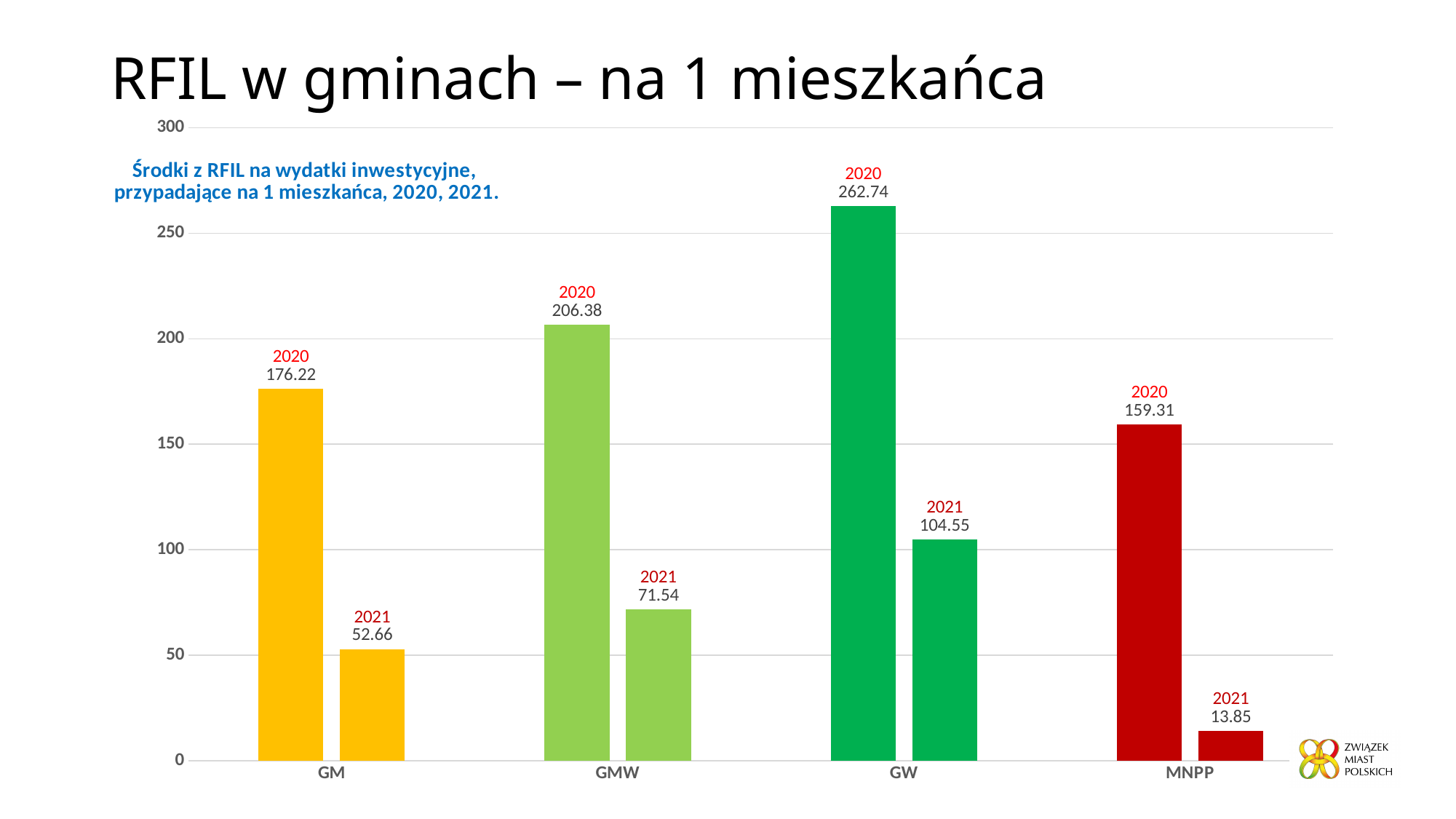
What is the 2020 value for GW? 262.74 What is the difference between the 2020 and 2021 values for GM? 123.56 What is the title of the slide? RFIL w gminach – na 1 mieszkańca Which category has the highest 2020 value? GW What is the 2021 value for GMW? 71.54 What is the 2021 value for MNPP? 13.85 Which is larger: the 2020 value for GMW or the 2020 value for MNPP? GMW What is the difference between the 2020 and 2021 values for GW? 158.19 What kind of chart is shown on the slide? bar chart How many categories are shown on the x axis? 4 Is the 2021 value for GW greater or less than 100? greater Which category has the lowest 2021 value? MNPP